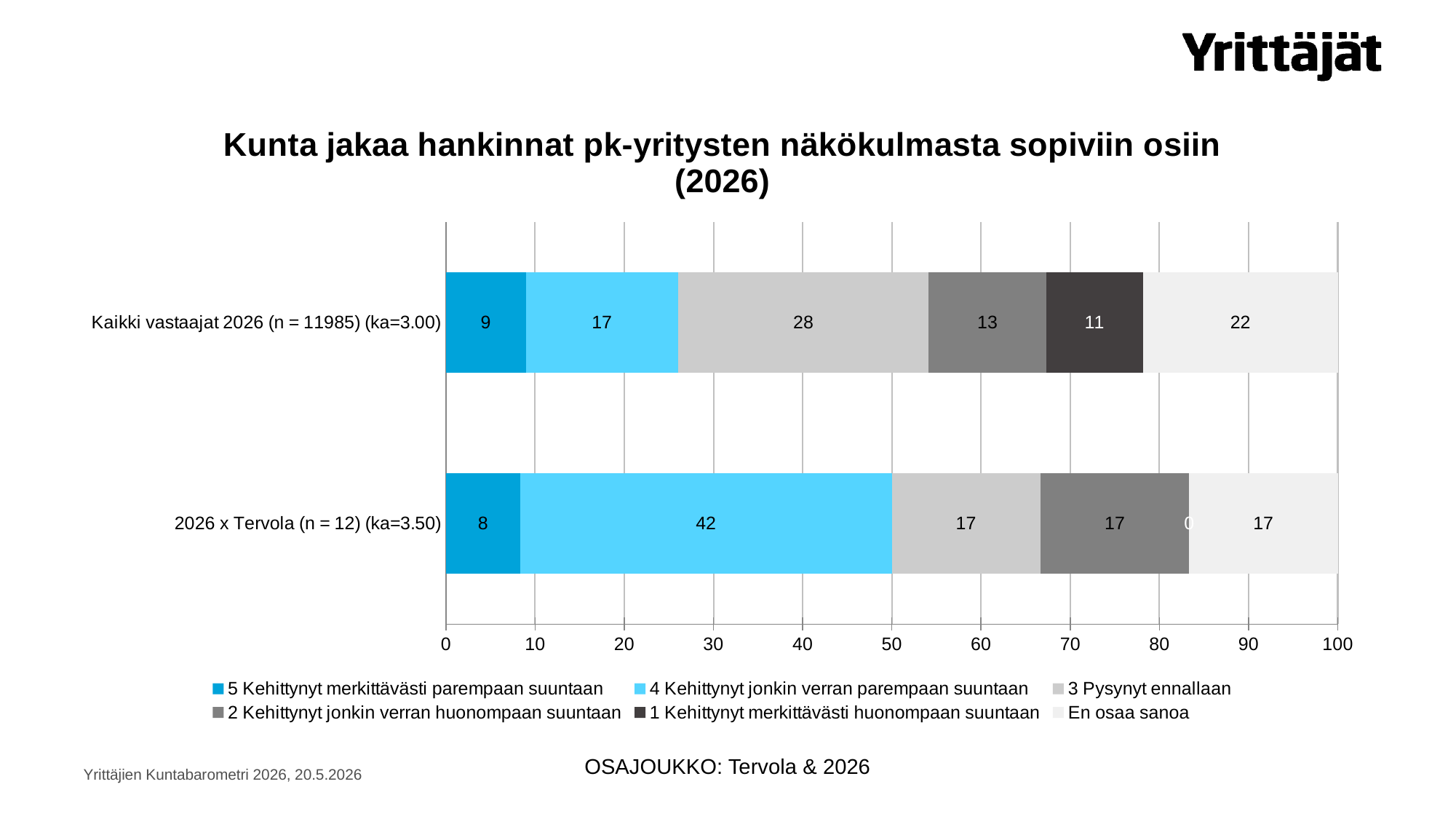
Which series has the largest value in the "2026 x Tervola (n = 12) (ka=3.50)" bar? 4 Kehittynyt jonkin verran parempaan suuntaan What is the value of "En osaa sanoa" for "Kaikki vastaajat 2026 (n = 11985) (ka=3.00)"? 22 What is the value of "1 Kehittynyt merkittävästi huonompaan suuntaan" for "2026 x Tervola (n = 12) (ka=3.50)"? 0 What is the difference between the "4 Kehittynyt jonkin verran parempaan suuntaan" values for "2026 x Tervola (n = 12) (ka=3.50)" and "Kaikki vastaajat 2026 (n = 11985) (ka=3.00)"? 25 How many categories (bars) are shown in the chart? 2 How many series does the legend list? 6 What is the value of "4 Kehittynyt jonkin verran parempaan suuntaan" for "2026 x Tervola (n = 12) (ka=3.50)"? 42 Which category has the larger value for "3 Pysynyt ennallaan": "Kaikki vastaajat 2026 (n = 11985) (ka=3.00)" or "2026 x Tervola (n = 12) (ka=3.50)"? Kaikki vastaajat 2026 (n = 11985) (ka=3.00) What kind of chart is shown on the slide? Stacked bar chart What is the value of "3 Pysynyt ennallaan" for "Kaikki vastaajat 2026 (n = 11985) (ka=3.00)"? 28 Which series has the smallest value in the "Kaikki vastaajat 2026 (n = 11985) (ka=3.00)" bar? 5 Kehittynyt merkittävästi parempaan suuntaan What is the title of the chart? Kunta jakaa hankinnat pk-yritysten näkökulmasta sopiviin osiin (2026)